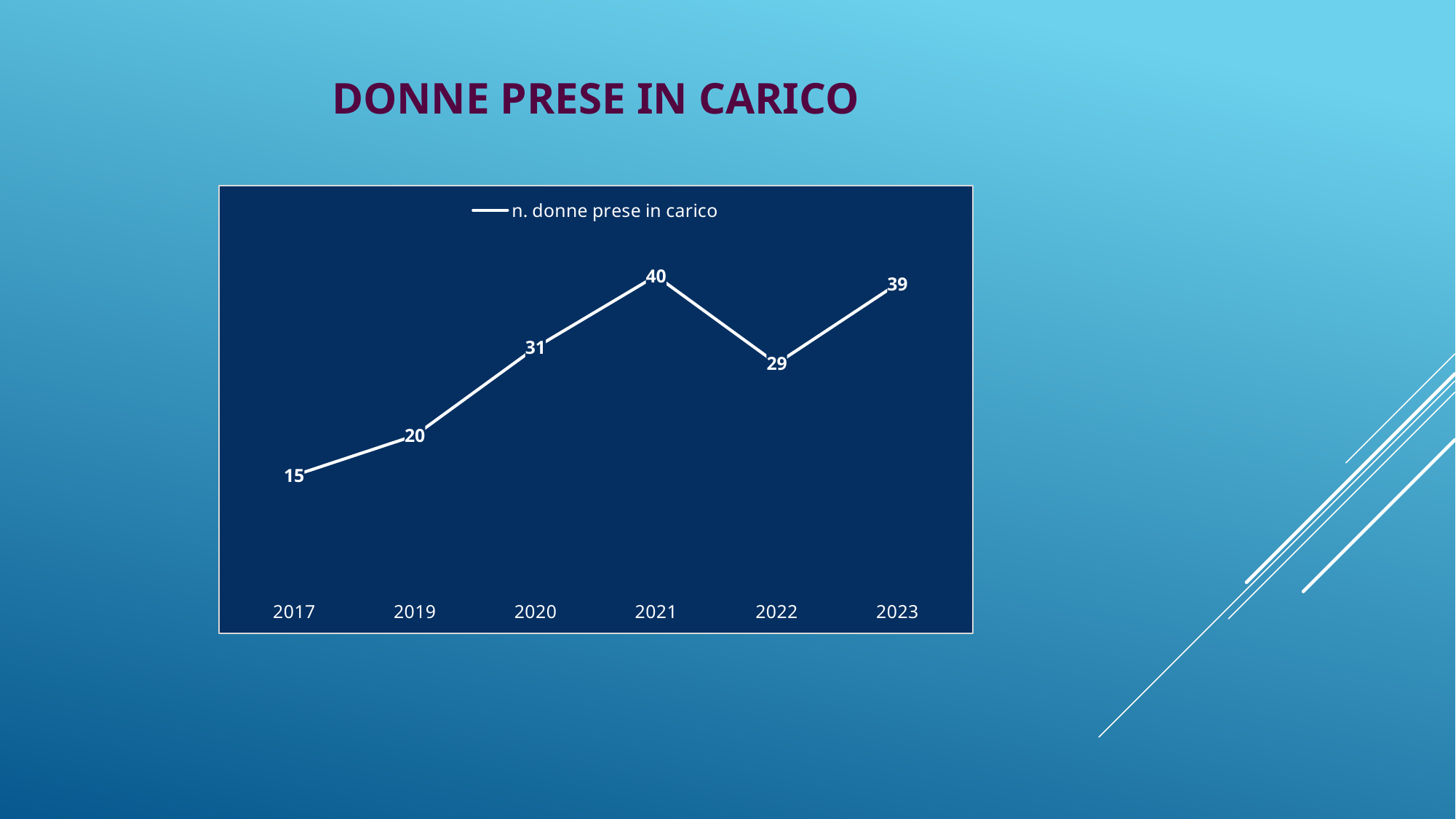
What kind of chart is shown? line chart What is the value for 2021? 40 What is the value for 2017? 15 Which year has the lowest value? 2017 How many series does the legend list? 1 How many years are plotted on the x axis? 6 What is the difference between the values for 2021 and 2022? 11 Which year has the highest value? 2021 Which is larger, the value for 2022 or the value for 2020? 2020 What is the value for 2023? 39 What is the legend entry for the plotted series? n. donne prese in carico What is the difference between the values for 2020 and 2019? 11